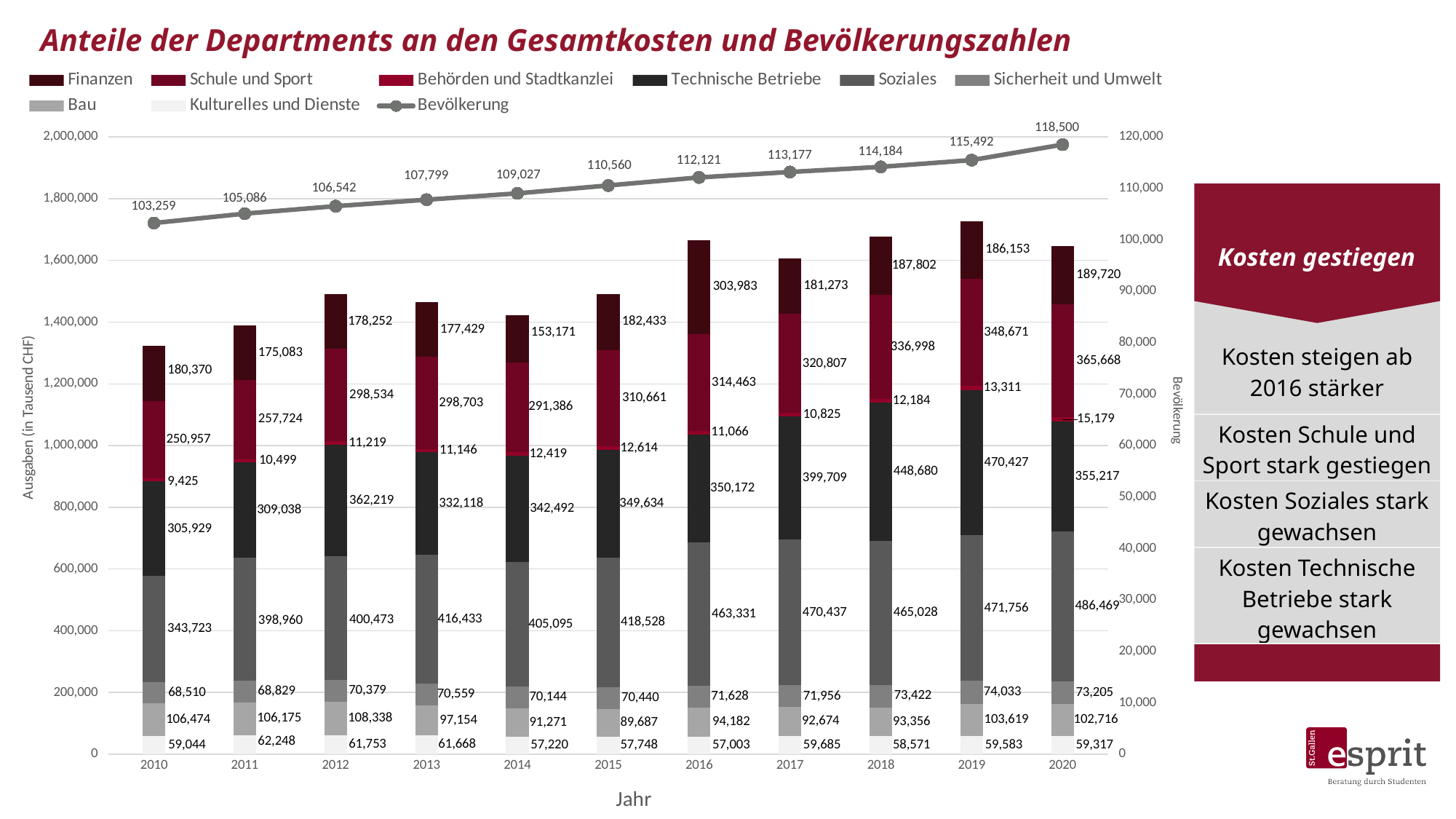
Does the Bevölkerung line rise or fall from 2010 to 2020? Rise How many series does the legend list? 9 What is the Bevölkerung value for 2020? 118,500 In which year is the Finanzen value highest? 2016 What kind of chart is shown? A stacked bar chart combined with a line chart How many years are shown on the x axis? 11 What is the value for Schule und Sport in 2013? 298,703 Which year has the larger value for Technische Betriebe, 2019 or 2020? 2019 By how much did the Bevölkerung increase from 2010 to 2020? 15,241 What is the total of the stacked bar for 2010? 1,324,432 In which year is the Kulturelles und Dienste value lowest? 2016 What is the value for Soziales in 2016? 463,331